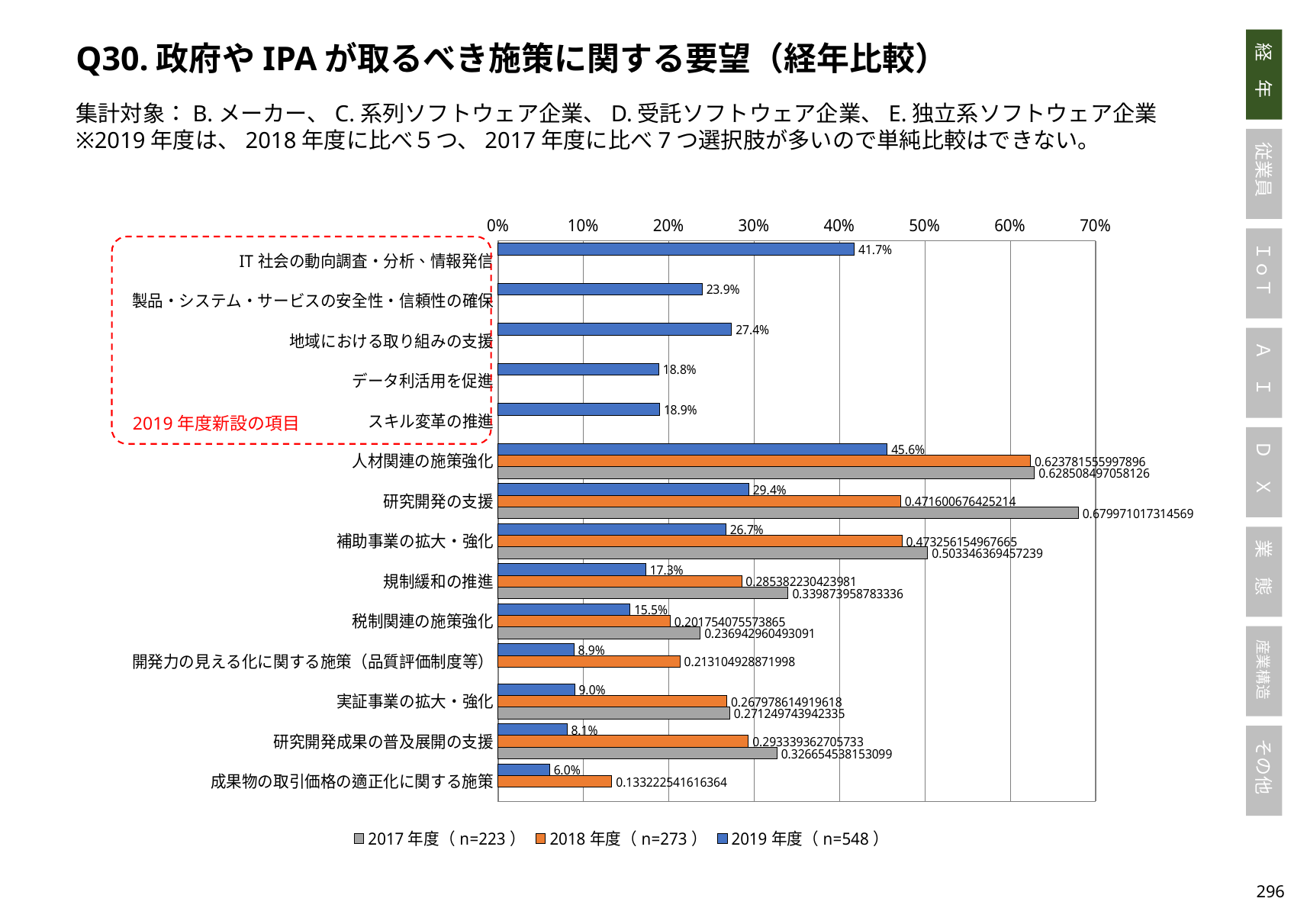
How many series does the legend list? 3 For 2019年度, which is larger: 研究開発の支援 or 補助事業の拡大・強化? 研究開発の支援 How many categories are shown on the chart? 14 What kind of chart is shown on the slide? Bar chart What is the 2017年度 value for 研究開発の支援? 0.679971017314569 What is the 2018年度 value for 研究開発の支援? 0.471600676425214 What is the difference between the 2019年度 values for 人材関連の施策強化 and IT社会の動向調査・分析、情報発信? 3.9% Which category has the lowest 2019年度 value? 成果物の取引価格の適正化に関する施策 What is the 2019年度 value for IT社会の動向調査・分析、情報発信? 41.7% Which category has the highest 2019年度 value? 人材関連の施策強化 What is the 2019年度 value for 人材関連の施策強化? 45.6% Which category has the highest 2017年度 value? 研究開発の支援